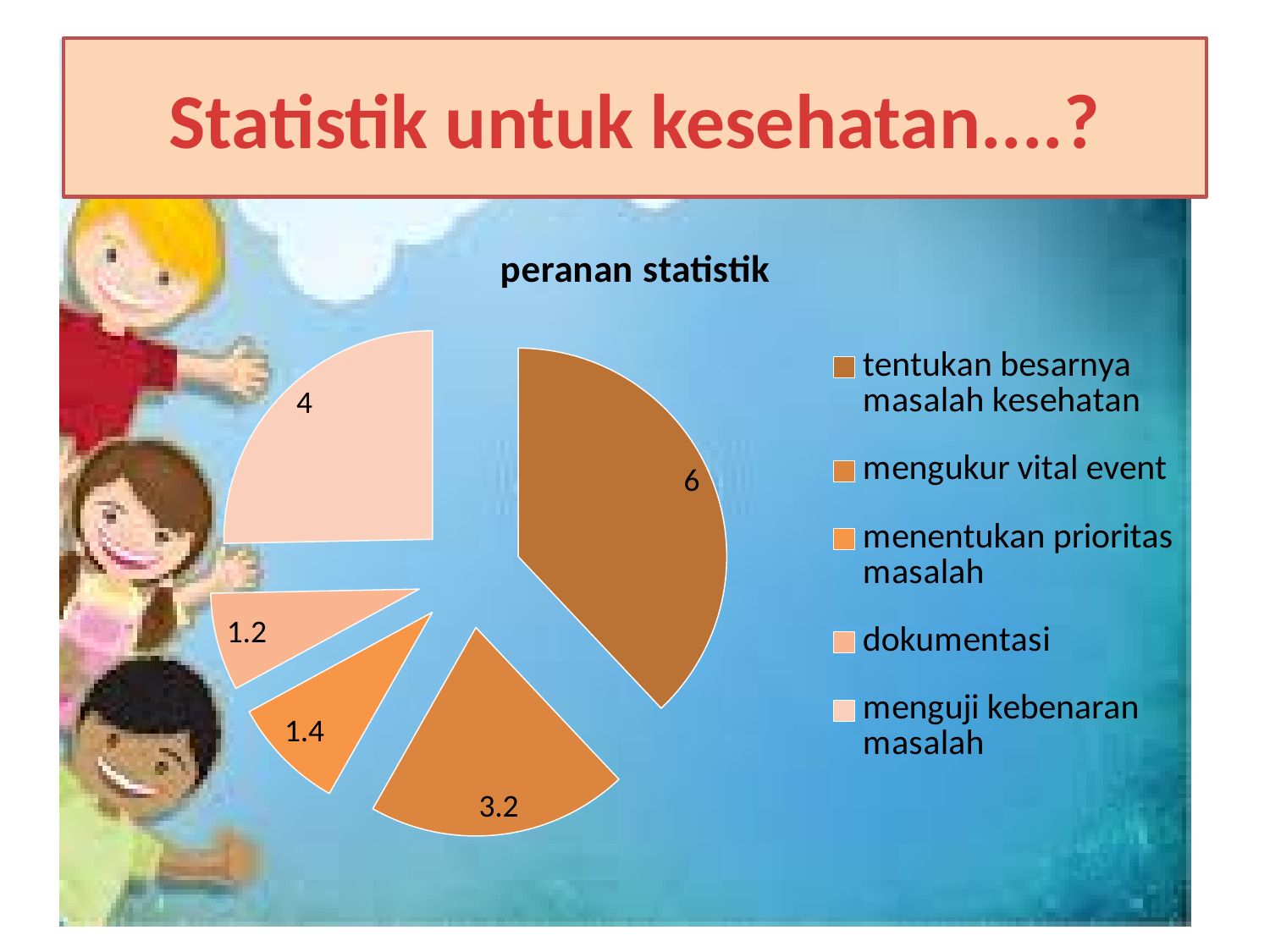
What is the value for 'mengukur vital event'? 3.2 What is the value for 'dokumentasi'? 1.2 What is the value for 'tentukan besarnya masalah kesehatan'? 6 What type of chart is shown on the slide? pie chart Which category has the smallest slice? dokumentasi Which category has the largest slice? tentukan besarnya masalah kesehatan How many entries does the legend list? 5 What is the difference between the values for 'tentukan besarnya masalah kesehatan' and 'menguji kebenaran masalah'? 2 What is the value for 'menguji kebenaran masalah'? 4 What is the title of the chart? peranan statistik How many slices does the pie chart have? 5 What is the value for 'menentukan prioritas masalah'? 1.4